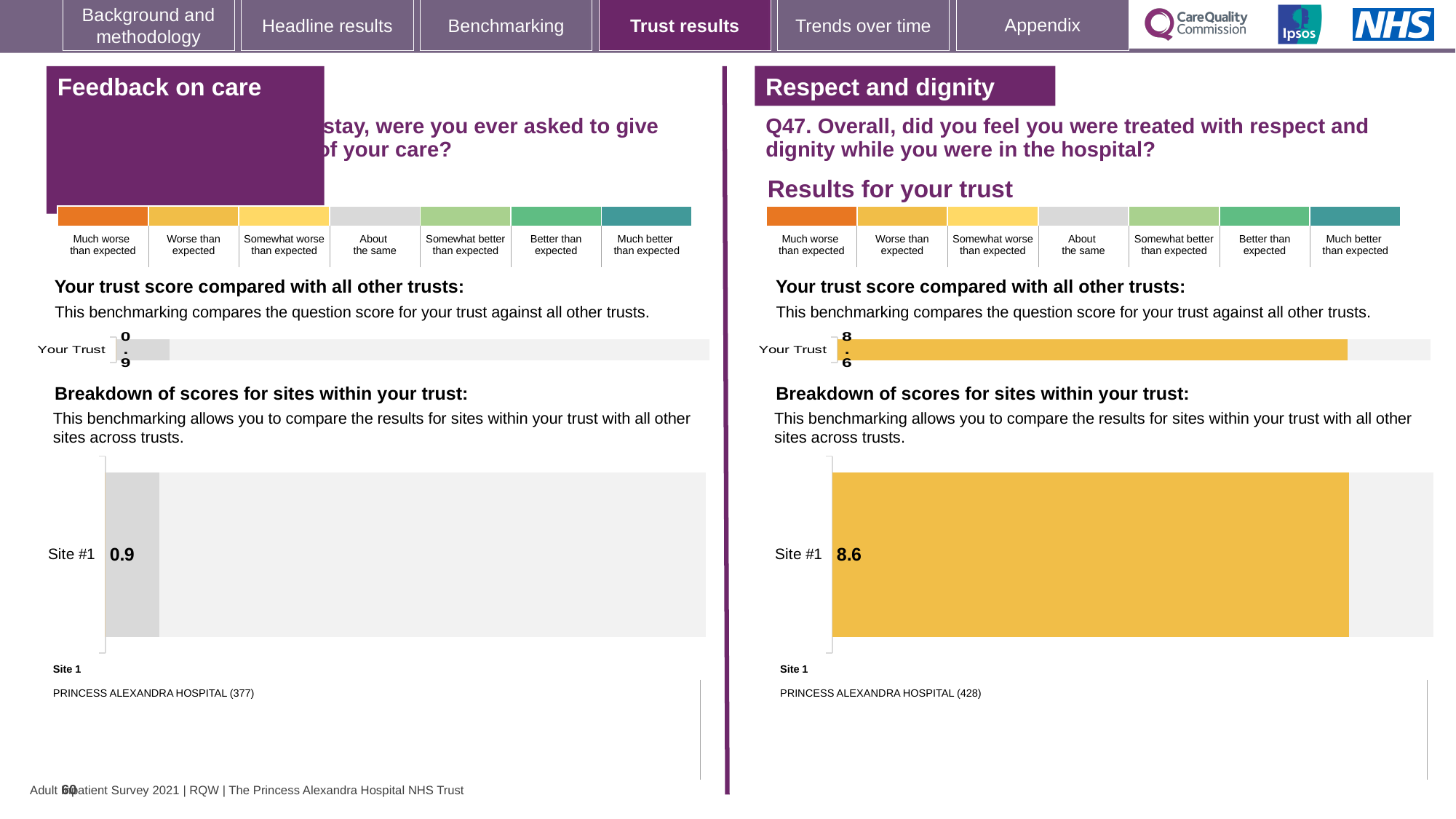
In the 'Feedback on care' section, what is the score shown for Site #1 in the breakdown of scores for sites chart? 0.9 What type of chart is used to show the Site #1 score in the 'Feedback on care' section? Bar chart In the 'Respect and dignity' section, what is the score shown for Site #1 in the breakdown of scores for sites chart? 8.6 How many sites are shown in the 'Breakdown of scores for sites within your trust' chart in the 'Respect and dignity' section? 1 In the 'Feedback on care' section, is the Site #1 score greater or less than 5? less In the 'Feedback on care' section, what is the 'Your Trust' score in the trust score comparison chart? 0.9 Which section shows the higher Site #1 score: 'Feedback on care' or 'Respect and dignity'? Respect and dignity What is the difference between the Site #1 score in the 'Respect and dignity' chart and the Site #1 score in the 'Feedback on care' chart? 7.7 In the 'Respect and dignity' section, what is the 'Your Trust' score in the trust score comparison chart? 8.6 What colour is the Site #1 bar in the 'Respect and dignity' breakdown chart? Yellow In the 'Respect and dignity' section, is the Site #1 score greater or less than 5? greater How many categories are shown in the colour scale legend above the 'Respect and dignity' charts? 7